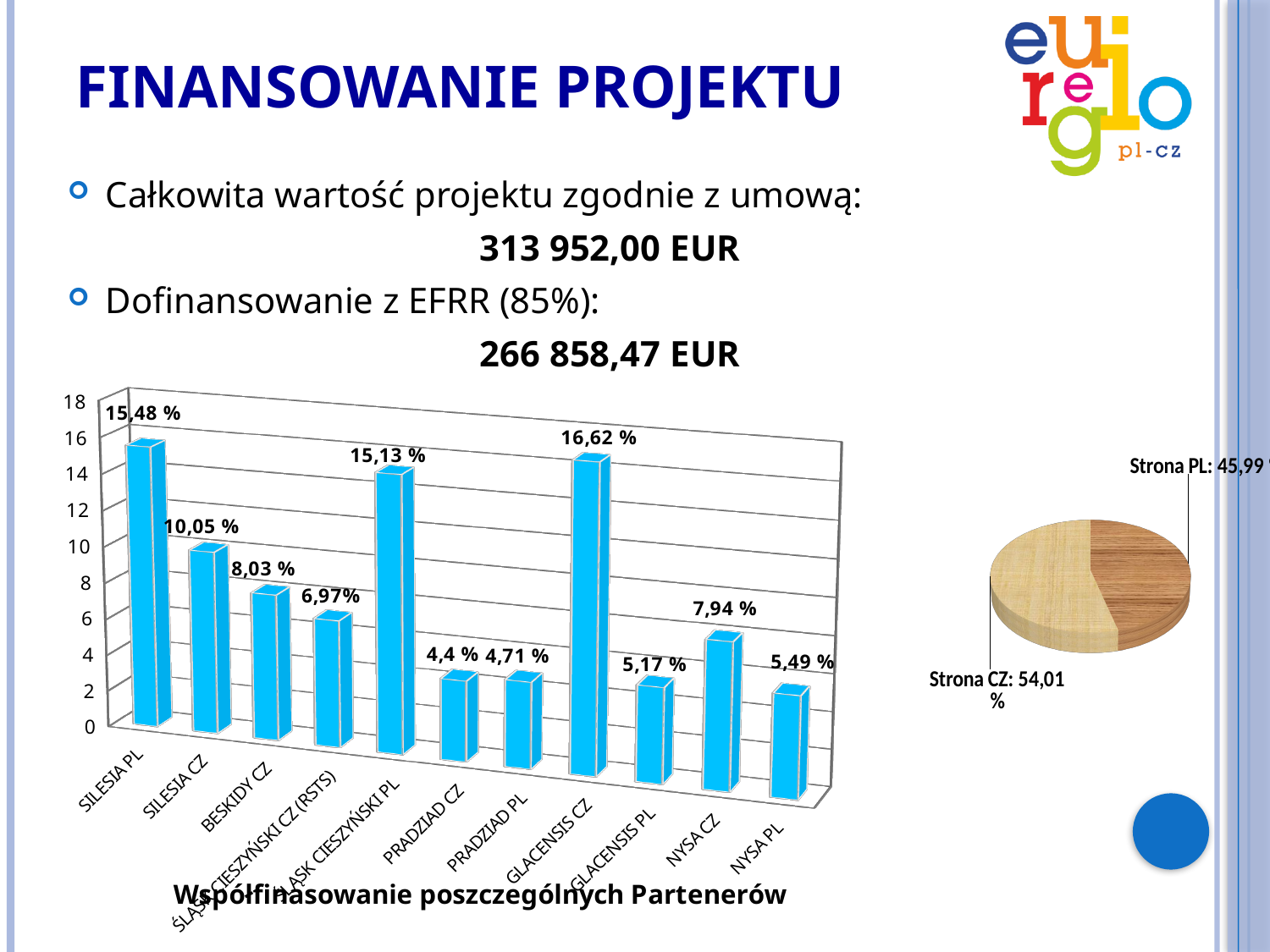
What type of chart is the chart on the left of the slide? bar chart In the bar chart, which is larger: BESKIDY CZ or NYSA PL? BESKIDY CZ In the bar chart, what is the difference between SILESIA PL and SILESIA CZ? 5,43 % In the bar chart, what is the value for GLACENSIS CZ? 16,62 % In the bar chart, what is the value for NYSA CZ? 7,94 % What is the title of the bar chart? Współfinasowanie poszczególnych Partenerów In the bar chart, which category has the lowest value? PRADZIAD CZ In the bar chart, what is the value for SILESIA PL? 15,48 % How many categories are shown in the bar chart? 11 In the bar chart, which category has the highest value? GLACENSIS CZ In the bar chart, is the value for GLACENSIS PL greater or less than 10? less In the pie chart, what share does Strona CZ have? 54,01 %